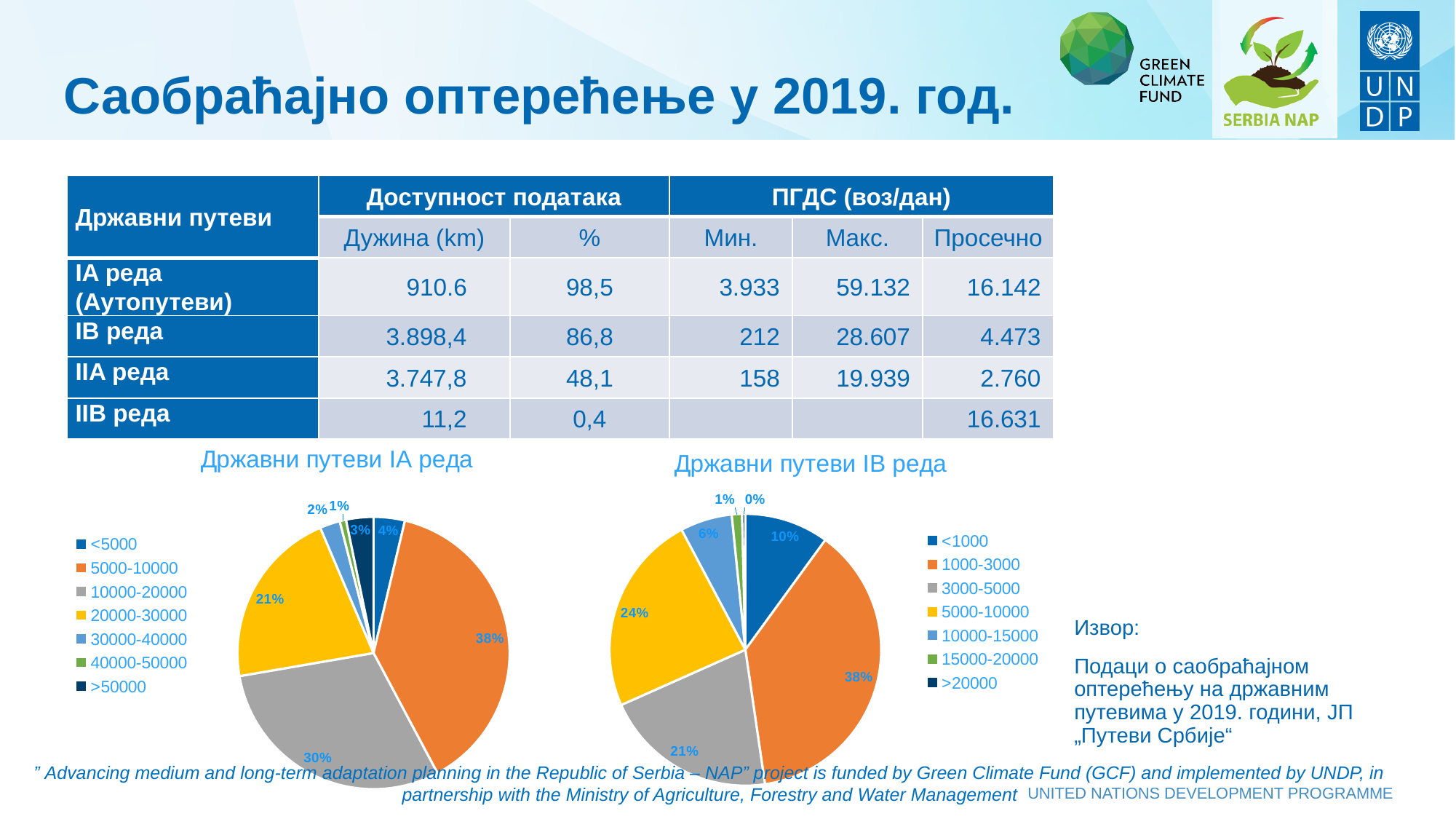
In the pie chart titled "Државни путеви IB реда", which category has the largest share? 1000-3000 In the pie chart titled "Државни путеви IB реда", what share does the <1000 category have? 10% In the pie chart titled "Државни путеви IB реда", which has the larger share, 5000-10000 or 10000-15000? 5000-10000 What type of chart is used for "Државни путеви IA реда"? Pie chart In the pie chart titled "Државни путеви IB реда", what share does the 5000-10000 category have? 24% In the pie chart titled "Државни путеви IA реда", what share does the 5000-10000 category have? 38% In the pie chart titled "Државни путеви IB реда", what colour represents the 1000-3000 category? Orange In the pie chart titled "Државни путеви IB реда", what is the difference in share between the 1000-3000 and 3000-5000 categories? 17% In the pie chart titled "Државни путеви IA реда", how many categories does the legend list? 7 In the pie chart titled "Државни путеви IA реда", which category has the largest share? 5000-10000